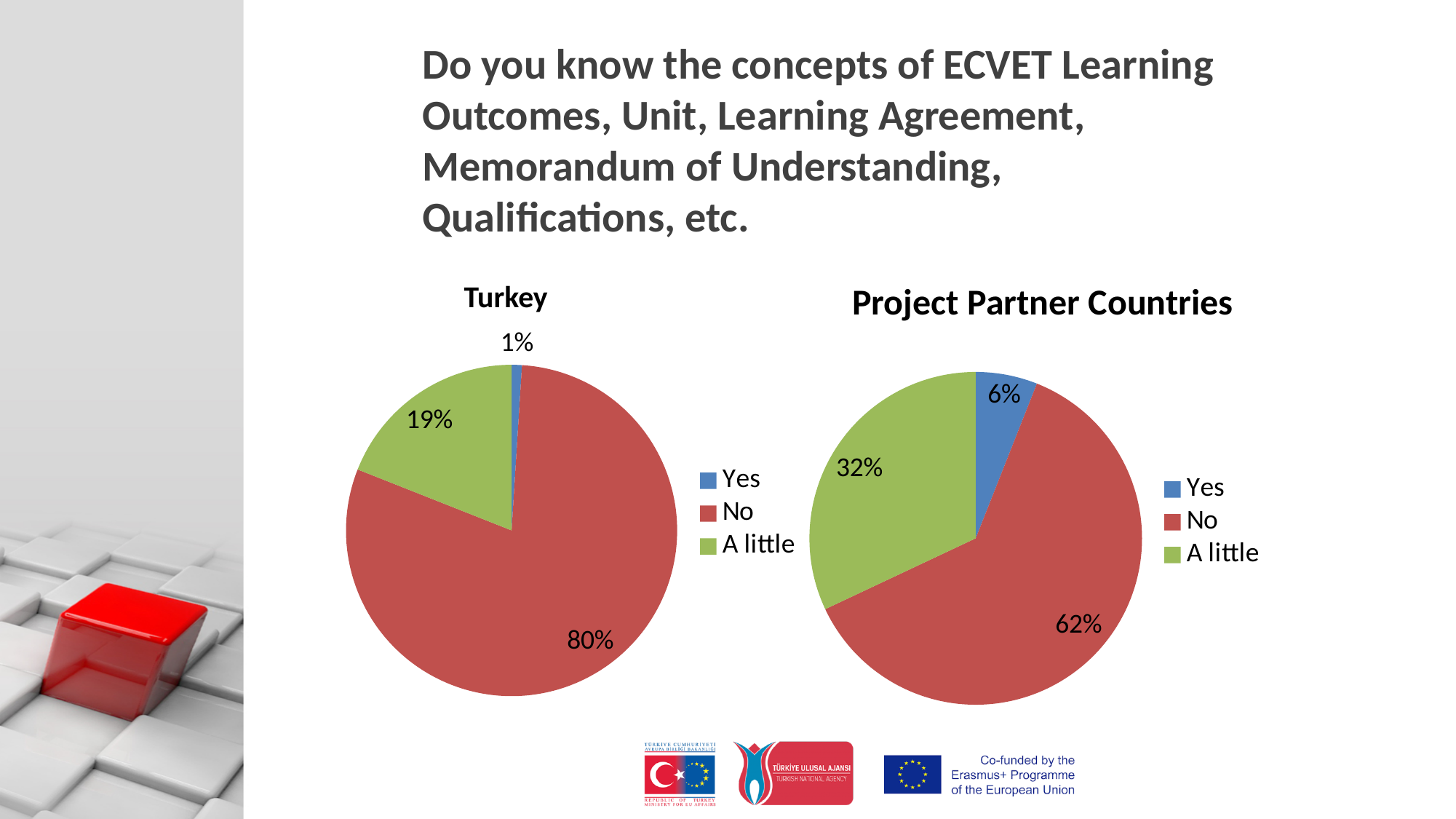
How many categories does the legend of the Turkey chart list? 3 Which chart shows a larger share for "A little", Turkey or Project Partner Countries? Project Partner Countries In the Project Partner Countries pie chart, which response has the smallest share? Yes In the Turkey pie chart, what percentage answered "A little"? 19% In the Turkey pie chart, which response has the largest share? No What type of chart is used for the Project Partner Countries data? Pie chart In the Project Partner Countries pie chart, what percentage answered "A little"? 32% In the Turkey pie chart, what percentage answered "No"? 80% In the Turkey pie chart, what percentage answered "Yes"? 1% What is the difference between the "No" share in the Turkey chart and the "No" share in the Project Partner Countries chart? 18% In the Project Partner Countries pie chart, what percentage answered "Yes"? 6% In the Project Partner Countries pie chart, what percentage answered "No"? 62%